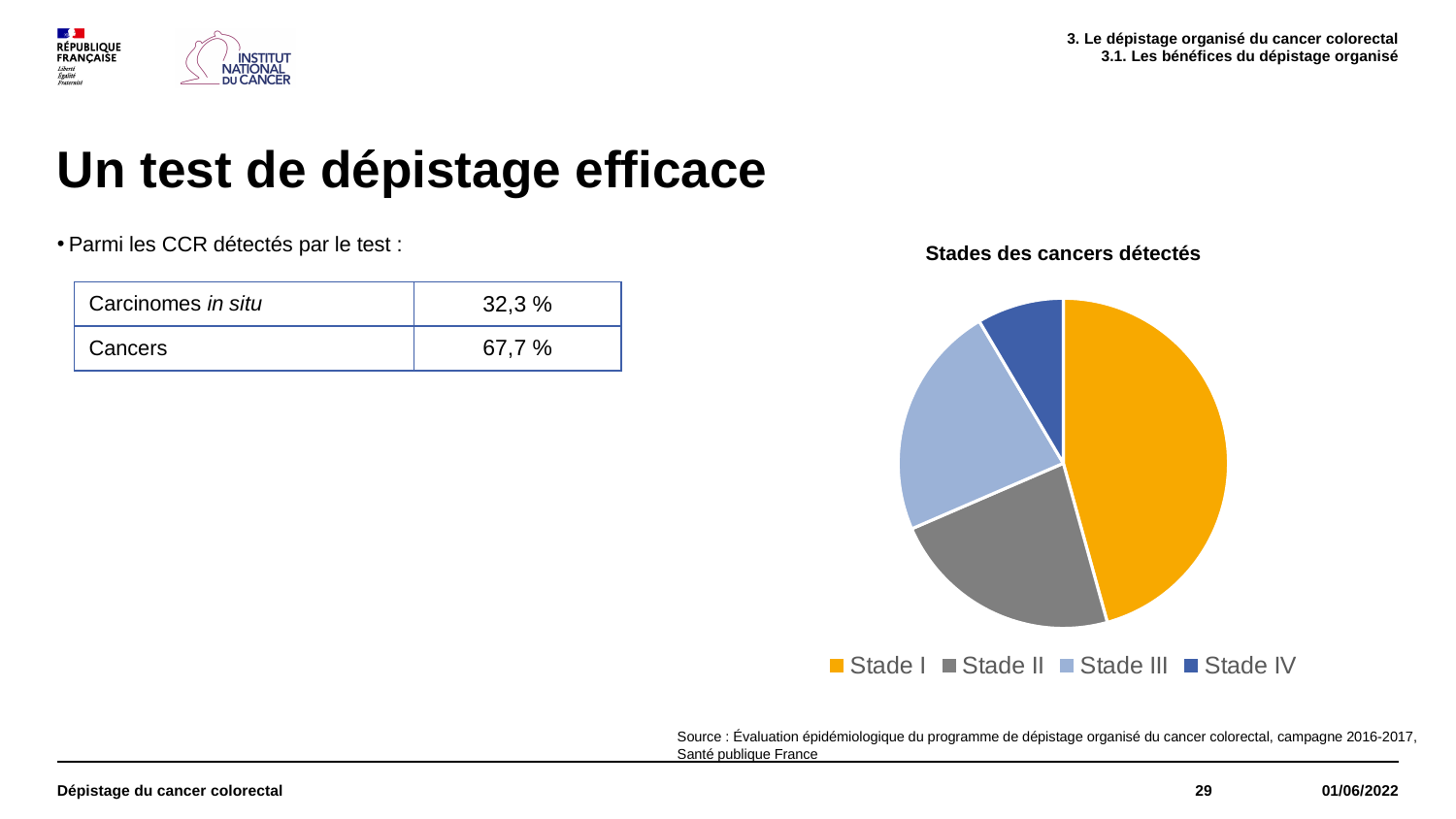
Which stage has the smallest slice in the pie chart? Stade IV How many entries does the legend of the pie chart list? 4 In the pie chart, which slice is larger: Stade III or Stade IV? Stade III In the pie chart, which slice is larger: Stade I or Stade IV? Stade I In the pie chart, which slice is larger: Stade I or Stade II? Stade I Which stage has the largest slice in the pie chart? Stade I Which colour represents Stade I in the pie chart? orange What is the title of the pie chart? Stades des cancers détectés What kind of chart is shown on the slide? pie chart How many slices does the pie chart have? 4